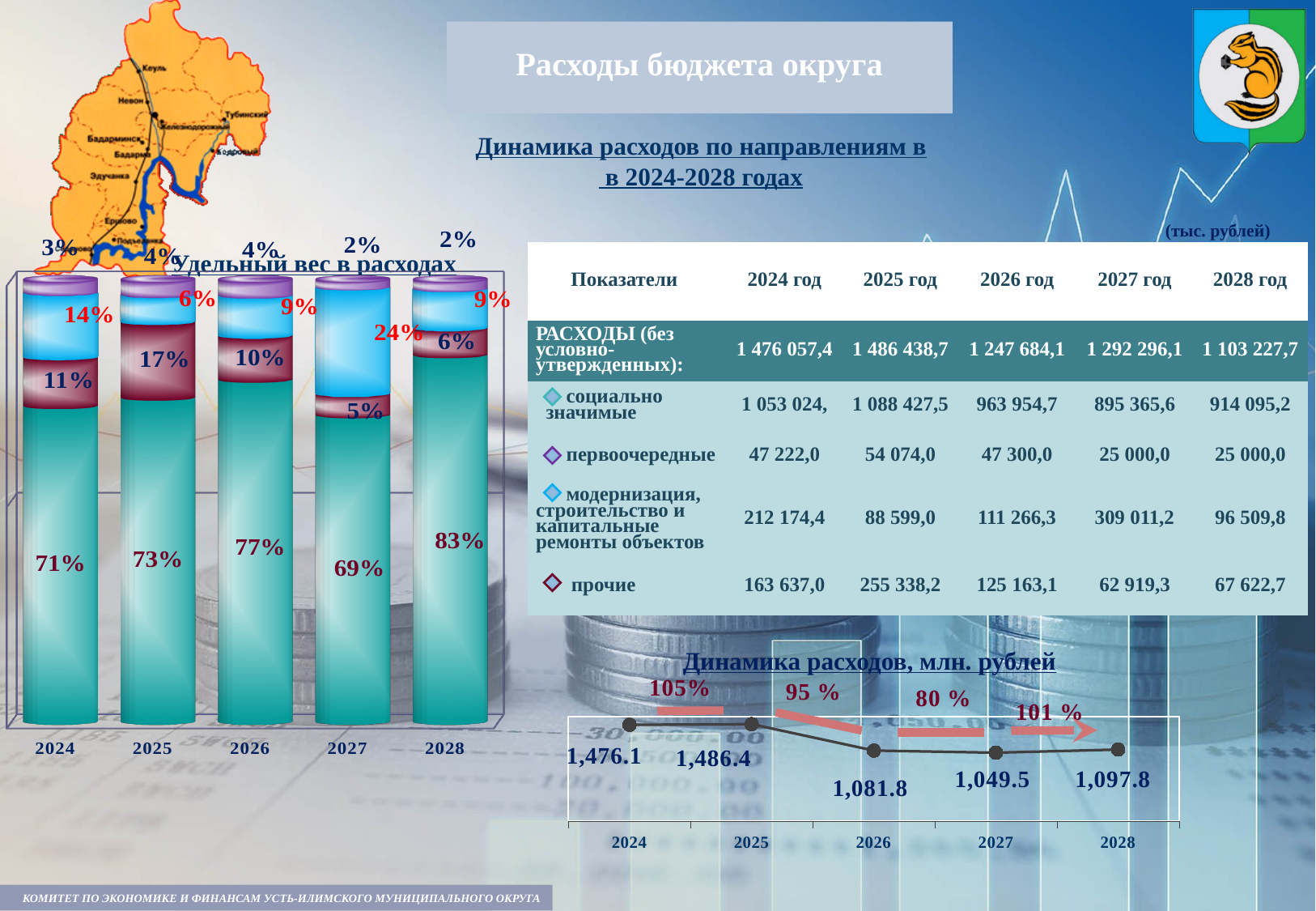
In the stacked bar chart 'Удельный вес в расходах', which year has the smallest bottom (teal) segment? 2027 In the line chart 'Динамика расходов, млн. рублей', what is the value for 2026? 1,081.8 In the line chart 'Динамика расходов, млн. рублей', do the values rise or fall from 2025 to 2027? fall In the stacked bar chart 'Удельный вес в расходах', what is the share of the bottom (teal) segment for 2028? 83% In the stacked bar chart 'Удельный вес в расходах', which year has the largest bottom (teal) segment? 2028 In the line chart 'Динамика расходов, млн. рублей', what is the difference between the 2025 and 2024 values? 10.3 In the line chart 'Динамика расходов, млн. рублей', which year has the lowest value? 2027 In the line chart 'Динамика расходов, млн. рублей', what percentage label is shown between 2026 and 2027? 80 % What type of chart is 'Удельный вес в расходах'? stacked bar chart In the line chart 'Динамика расходов, млн. рублей', which year has the highest value? 2025 In the stacked bar chart 'Удельный вес в расходах', is the bottom (teal) segment larger in 2026 or in 2024? 2026 In the line chart 'Динамика расходов, млн. рублей', how many data points are plotted? 5